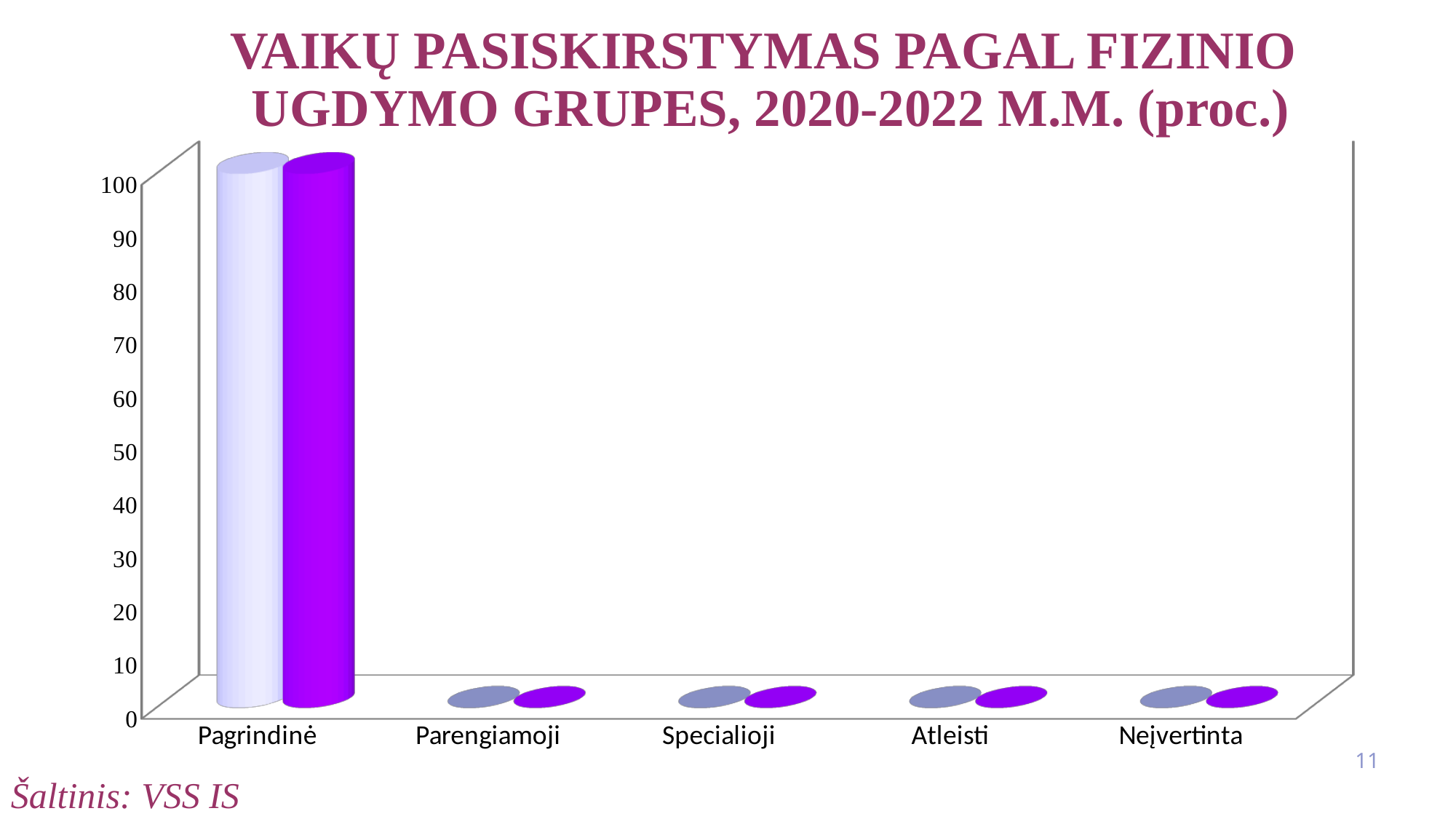
Is the value of the purple bar for Parengiamoji greater or less than 10? less Is the value of the purple bar for Pagrindinė greater or less than 80? greater Which is larger: the light-coloured bar for Pagrindinė or the light-coloured bar for Atleisti? Pagrindinė What is the highest tick value shown on the vertical axis of the chart? 100 What is the title of the chart on the slide? VAIKŲ PASISKIRSTYMAS PAGAL FIZINIO UGDYMO GRUPES, 2020-2022 M.M. (proc.) Which category has the highest values in the chart? Pagrindinė What kind of chart is shown on the slide? bar chart Is the value of the purple bar for Atleisti greater or less than 20? less Which is larger: the purple bar for Pagrindinė or the purple bar for Neįvertinta? Pagrindinė How many categories are shown on the x axis of the chart? 5